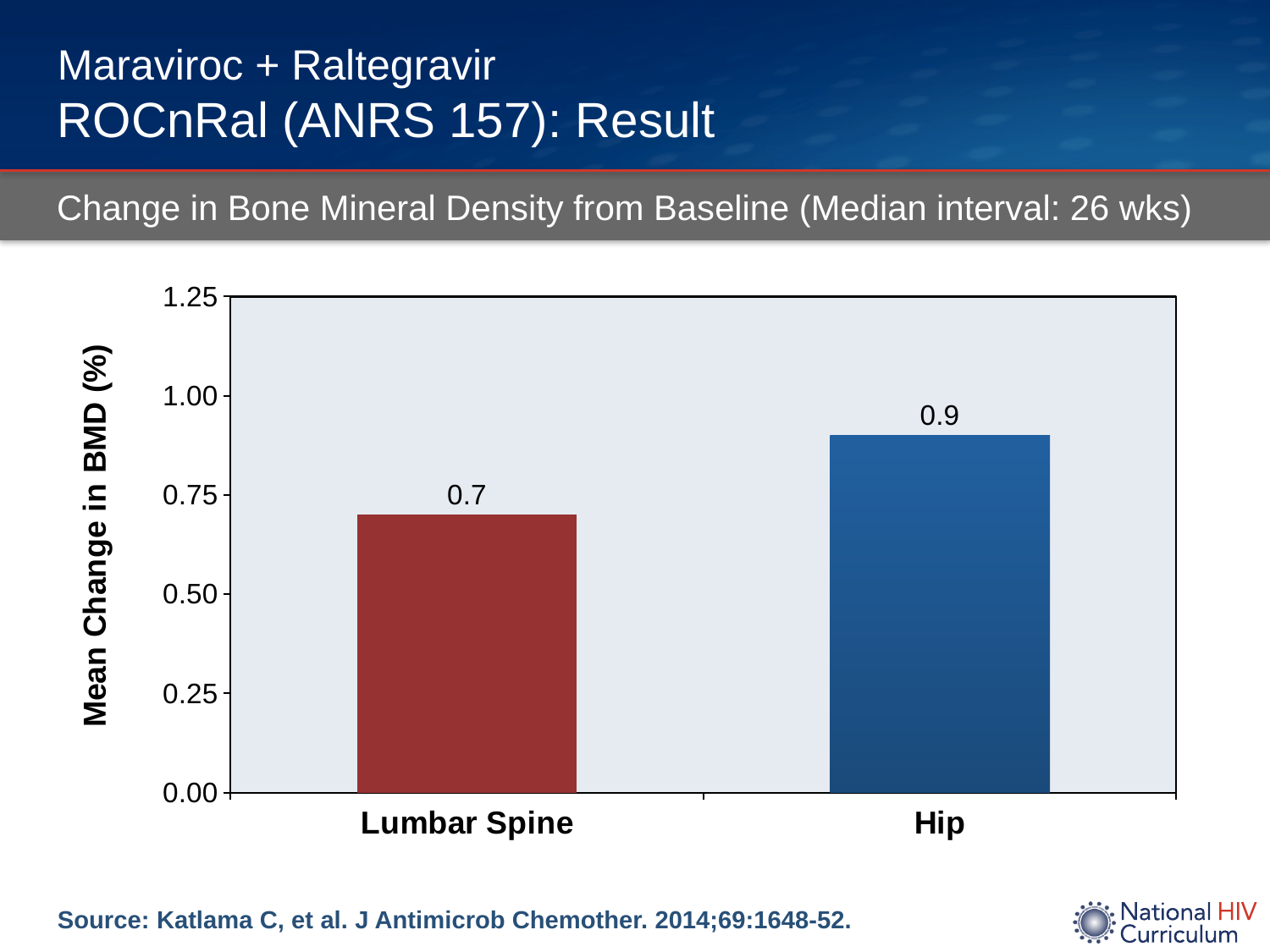
Is the value for Lumbar Spine greater or less than 0.50? greater What is the mean change in BMD (%) for Hip? 0.9 Is the value for Hip greater or less than 1.00? less What is the label of the y axis? Mean Change in BMD (%) What colour is the bar for Lumbar Spine? Red What kind of chart is shown on the slide? Bar chart Which category has the higher mean change in BMD? Hip What is the difference between the mean change in BMD for Hip and for Lumbar Spine? 0.2 Is the mean change in BMD larger for Lumbar Spine or for Hip? Hip How many categories are shown on the x axis? 2 Which category has the lower mean change in BMD? Lumbar Spine What is the mean change in BMD (%) for Lumbar Spine? 0.7